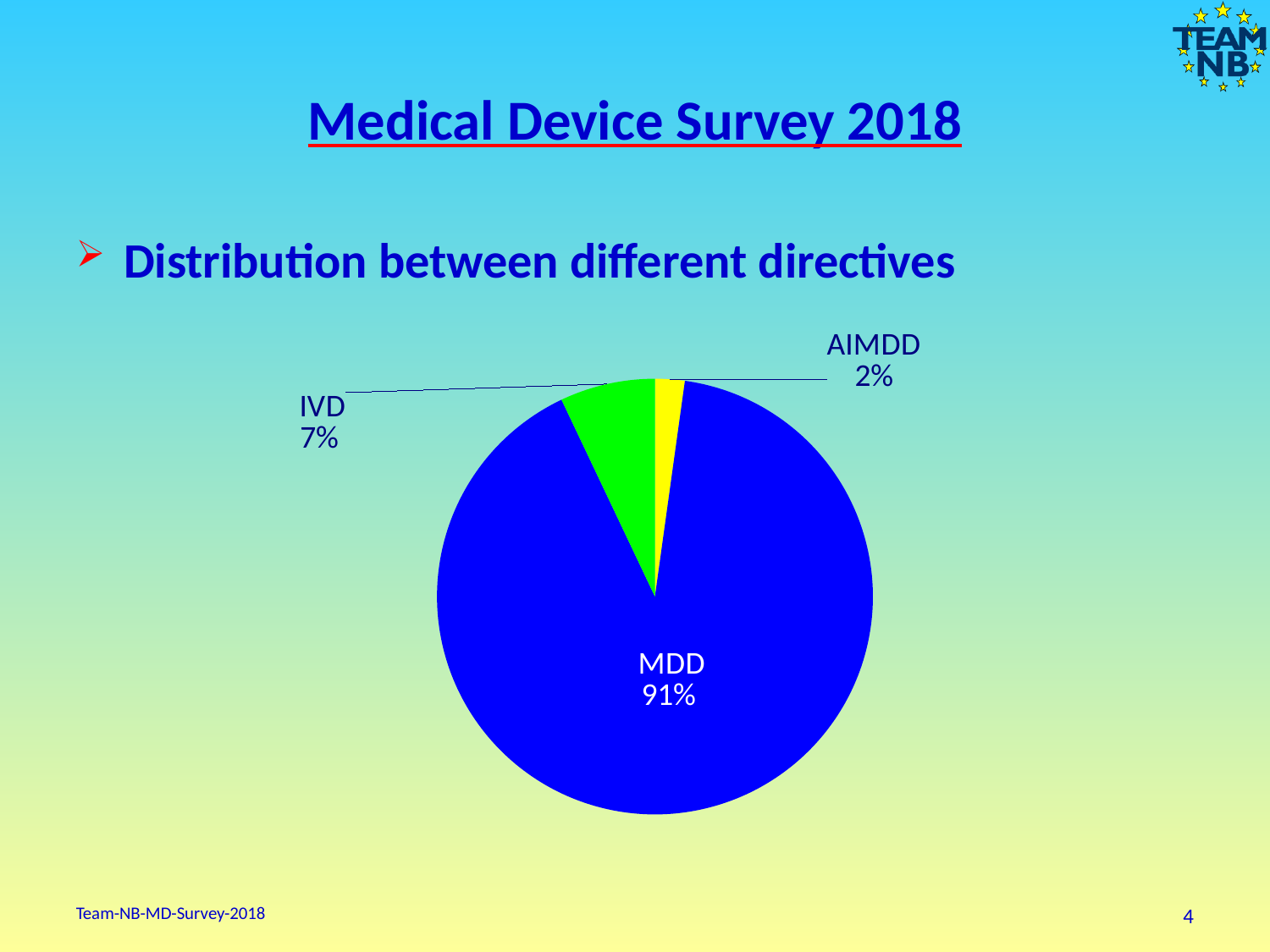
What colour is the MDD slice? Blue Which directive has the smallest slice of the pie? AIMDD What share of the pie does AIMDD account for? 2% What kind of chart is shown on the slide? Pie chart What share of the pie does MDD account for? 91% What is the difference in percentage points between the IVD and AIMDD shares? 5 What share of the pie does IVD account for? 7% Which has a larger share, IVD or AIMDD? IVD How many slices does the pie chart have? 3 Which directive has the largest slice of the pie? MDD What is the difference in percentage points between the MDD and IVD shares? 84 What colour is the IVD slice? Green